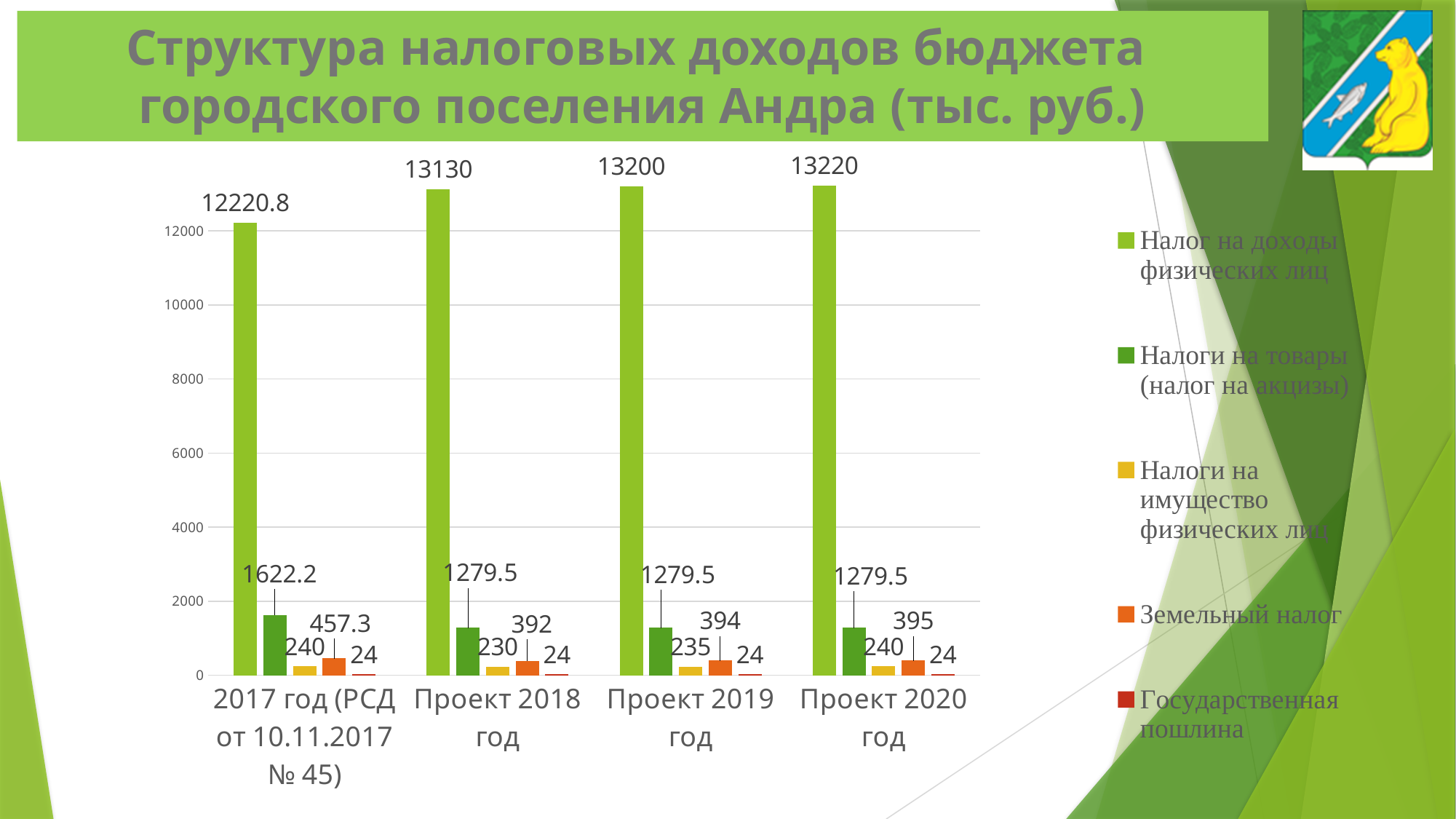
In which category is Земельный налог the lowest? Проект 2018 год Is the value of Налог на доходы физических лиц for 2017 год (РСД от 10.11.2017 № 45) greater or less than 12000? greater What is the value of Налог на доходы физических лиц for Проект 2019 год? 13200 What is the value of Налоги на имущество физических лиц for Проект 2018 год? 230 What is the value of Земельный налог for 2017 год (РСД от 10.11.2017 № 45)? 457.3 What is the value of Налоги на товары (налог на акцизы) for Проект 2020 год? 1279.5 Which is larger: Налоги на товары (налог на акцизы) for 2017 год (РСД от 10.11.2017 № 45) or for Проект 2019 год? 2017 год (РСД от 10.11.2017 № 45) How many series does the legend list? 5 How many categories are shown on the x axis? 4 What is the difference between Налог на доходы физических лиц for Проект 2018 год and for 2017 год (РСД от 10.11.2017 № 45)? 909.2 What kind of chart is shown on the slide? bar chart In which category is Налог на доходы физических лиц the highest? Проект 2020 год